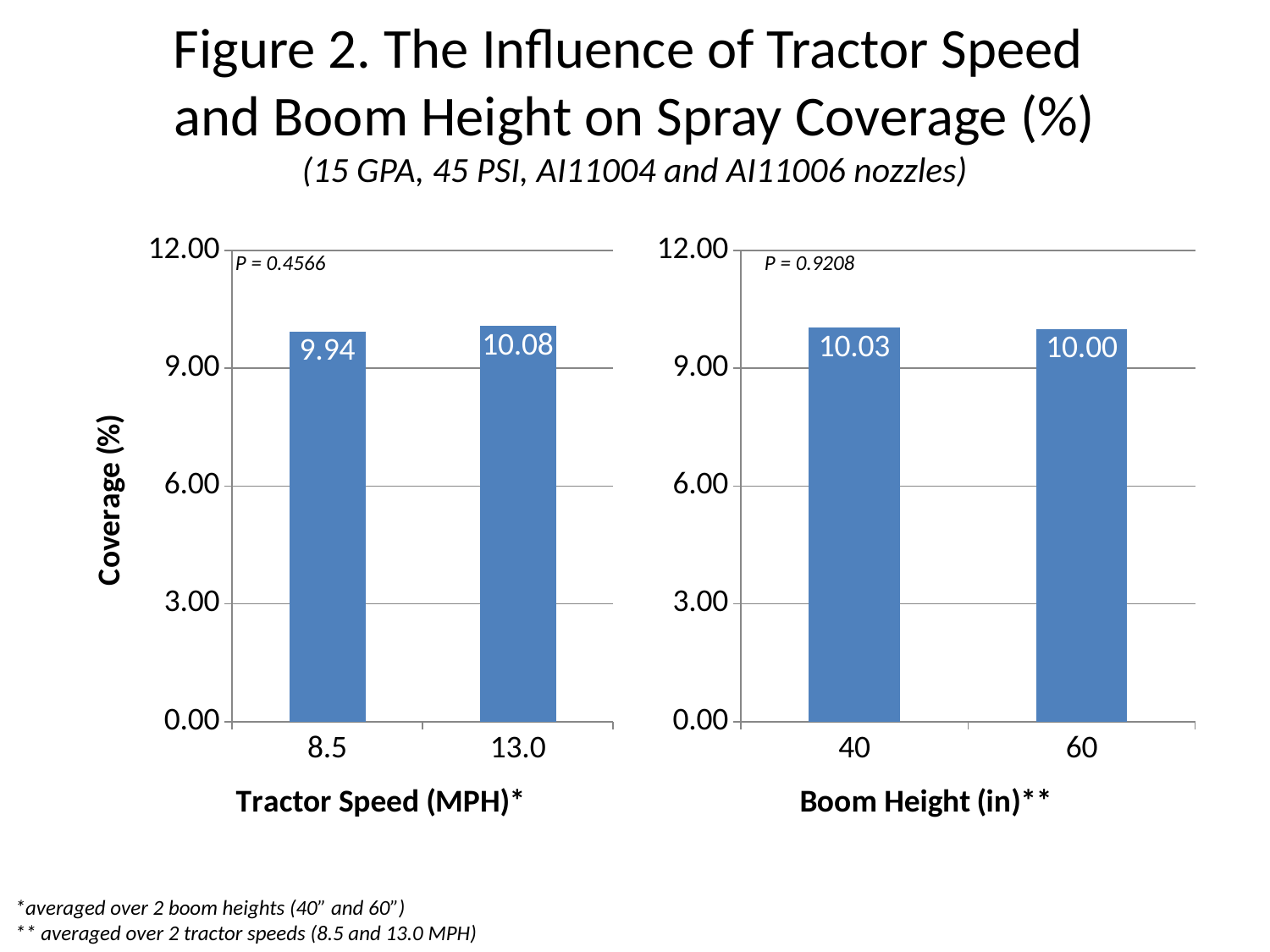
In the left chart (Tractor Speed), is the coverage value for 8.5 MPH greater or less than 9.00? greater In the right chart (Boom Height), what is the difference in coverage between 40 in and 60 in? 0.03 In the right chart (Boom Height), which boom height has the lower coverage according to the data labels? 60 In the left chart (Tractor Speed), what is the coverage value for 8.5 MPH? 9.94 In the left chart (Tractor Speed), what is the difference in coverage between 13.0 MPH and 8.5 MPH? 0.14 In the left chart (Tractor Speed), what is the coverage value for 13.0 MPH? 10.08 In the right chart (Boom Height), what is the coverage value for 40 in? 10.03 What P value is printed on the right chart (Boom Height)? P = 0.9208 In the right chart (Boom Height), what is the coverage value for 60 in? 10.00 In the left chart (Tractor Speed), which tractor speed has the higher coverage according to the data labels? 13.0 How many bars are shown in the right chart (Boom Height)? 2 What type of chart is the left chart (Tractor Speed)? Bar chart